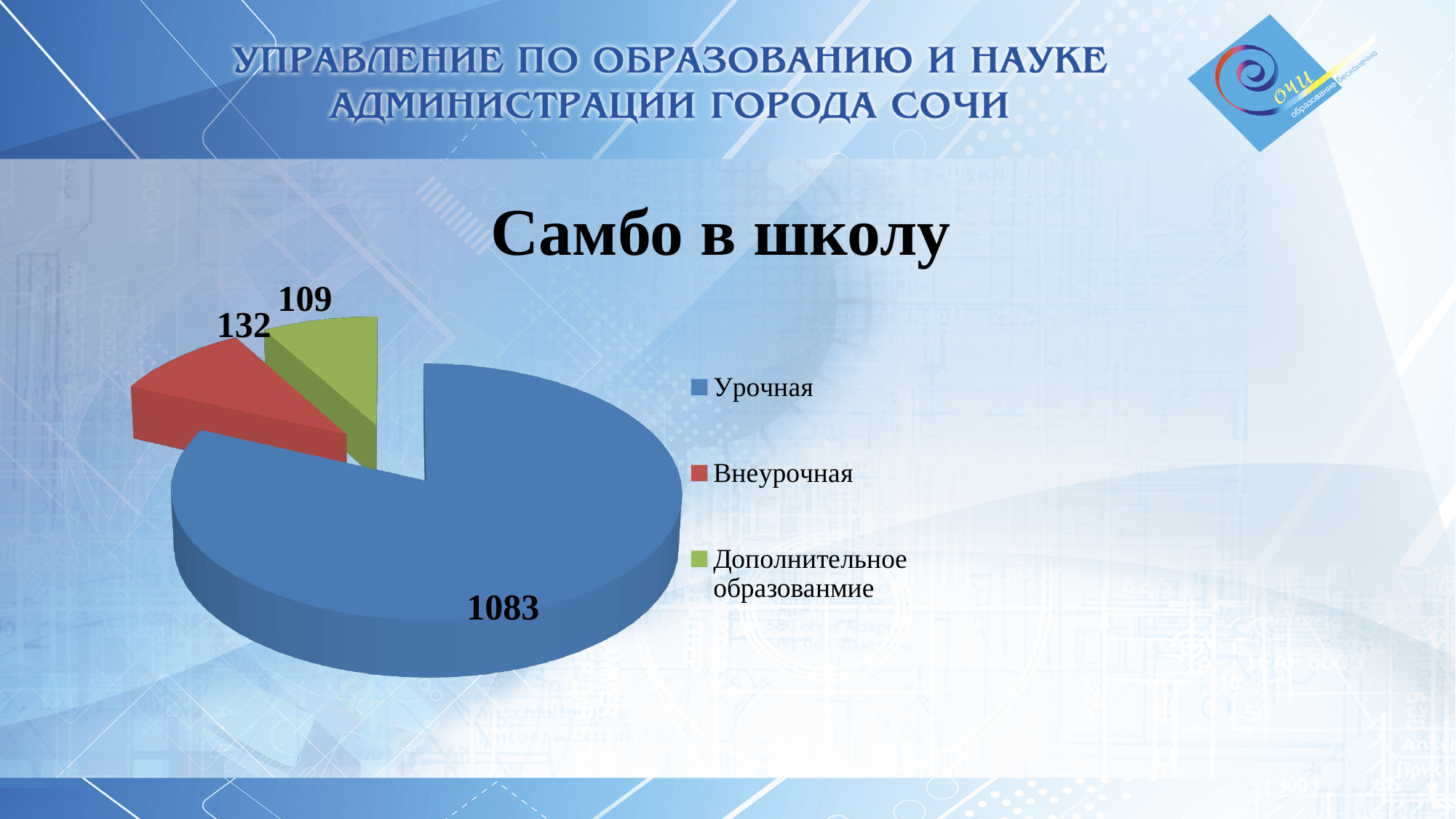
What is the value for Урочная? 1083 Which category has the smallest slice? Дополнительное образованмие Which category has the largest slice? Урочная What kind of chart is shown on the slide? pie chart What is the value for Дополнительное образованмие? 109 What is the title of the chart? Самбо в школу Which is larger, the value for Внеурочная or the value for Дополнительное образованмие? Внеурочная What is the difference between the values for Урочная and Внеурочная? 951 What is the difference between the values for Внеурочная and Дополнительное образованмие? 23 How many categories does the pie chart have? 3 What colour is the slice for Урочная? blue What is the value for Внеурочная? 132